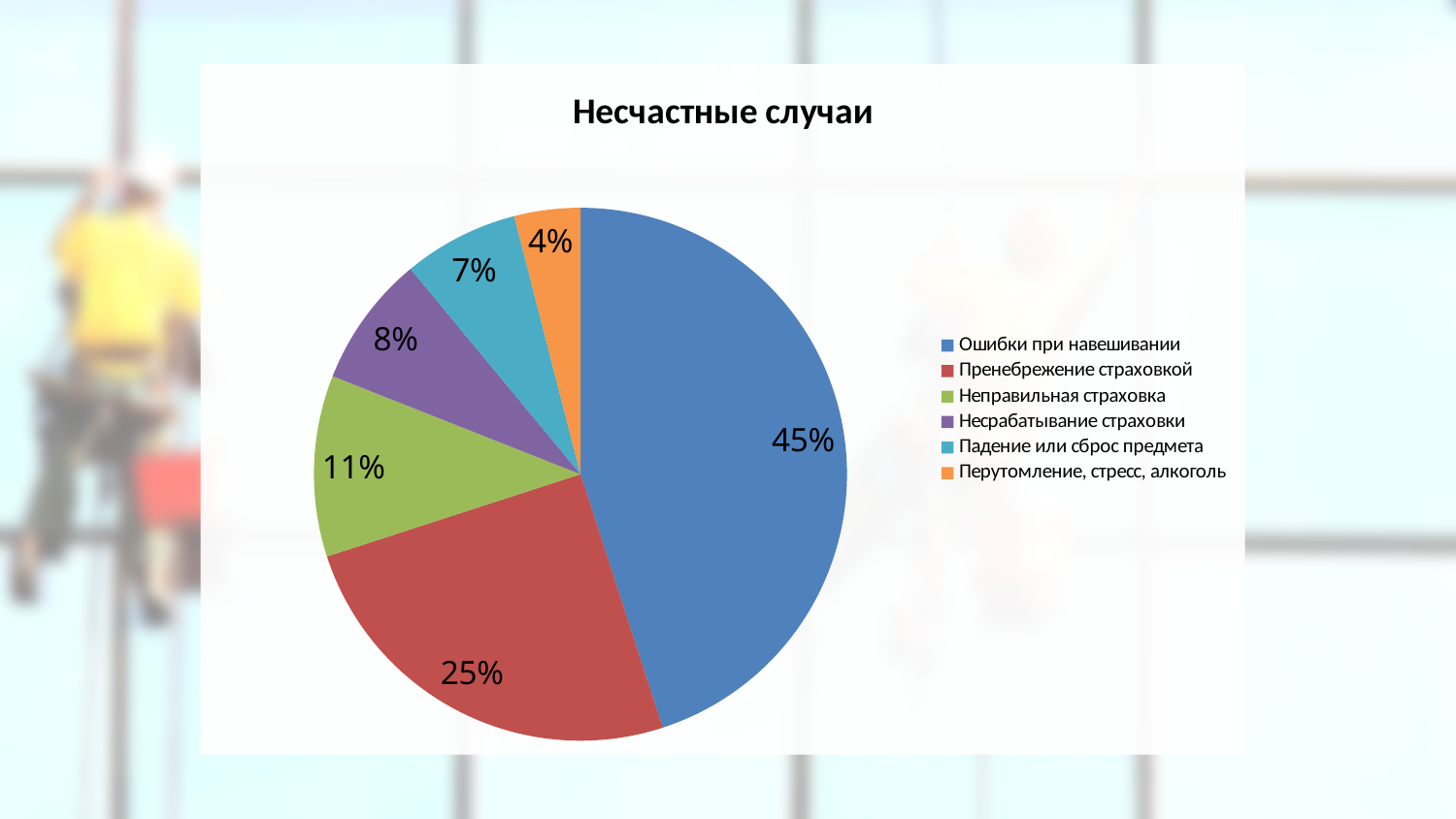
What share of the pie does "Ошибки при навешивании" have? 45% What share of the pie does "Неправильная страховка" have? 11% How many categories does the pie chart have? 6 What colour is the slice for "Падение или сброс предмета"? Light blue What share of the pie does "Пренебрежение страховкой" have? 25% Which is larger: the share for "Несрабатывание страховки" or the share for "Падение или сброс предмета"? Несрабатывание страховки Which category has the smallest slice of the pie? Перутомление, стресс, алкоголь What type of chart is shown on the slide? Pie chart What is the difference between the shares of "Ошибки при навешивании" and "Пренебрежение страховкой"? 20% What is the title of the chart? Несчастные случаи Which category has the largest slice of the pie? Ошибки при навешивании What share of the pie does "Перутомление, стресс, алкоголь" have? 4%